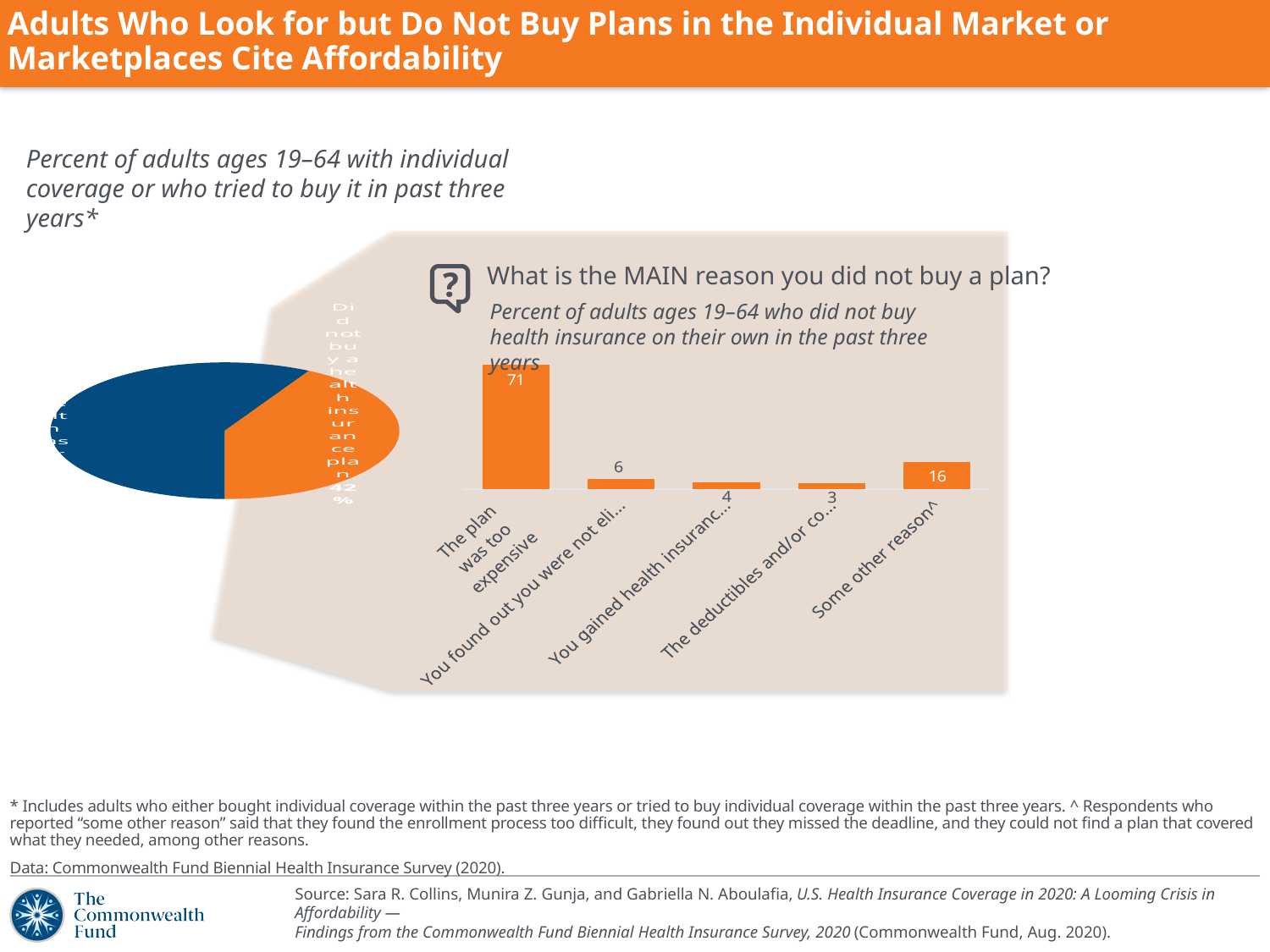
In the bar chart on the right, what is the difference between the value for 'The plan was too expensive' and the value for 'Some other reason'? 55 How many reasons (bars) are shown in the bar chart on the right? 5 What kind of chart is the chart on the right of the slide? Bar chart In the bar chart on the right, what is the value for the bar labeled 'The deductibles and/or co...'? 3 In the bar chart on the right, what is the value for the bar labeled 'You found out you were not eli...'? 6 What kind of chart is the chart on the left of the slide? Pie chart What question is posed as the heading of the bar chart on the right? What is the MAIN reason you did not buy a plan? In the bar chart on the right, what is the value for 'Some other reason'? 16 In the bar chart on the right, which reason has the highest value? The plan was too expensive In the bar chart on the right, which is larger: the value for 'Some other reason' or the value for 'You found out you were not eli...'? Some other reason In the bar chart on the right, what percent of adults said the main reason they did not buy a plan was that the plan was too expensive? 71 In the bar chart on the right, which reason has the lowest value? The deductibles and/or co...